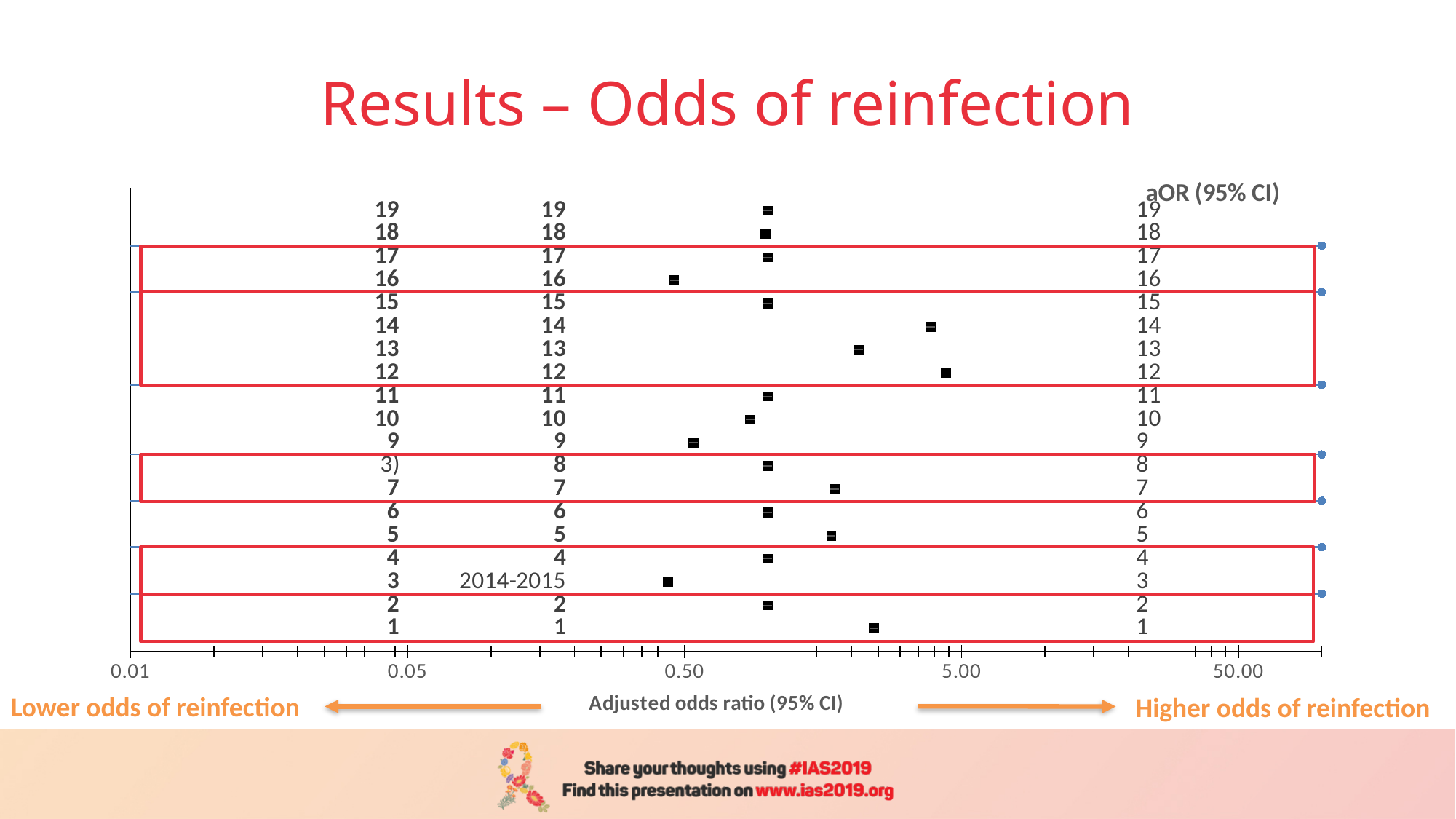
Which has the larger value, row 12 or row 16? row 12 Which has the larger value, row 1 or row 10? row 1 Is the value for row 13 greater or less than 5.00? less How many data points (rows) are plotted in the chart? 19 What kind of chart is shown on the slide? scatter (dot) plot What is the largest tick value shown on the x axis? 50.00 Is the value for row 12 greater or less than 0.50? greater What is the title of the x axis of the chart? Adjusted odds ratio (95% CI) Is the value for row 1 greater or less than 0.50? greater Which has the larger value, row 13 or row 9? row 13